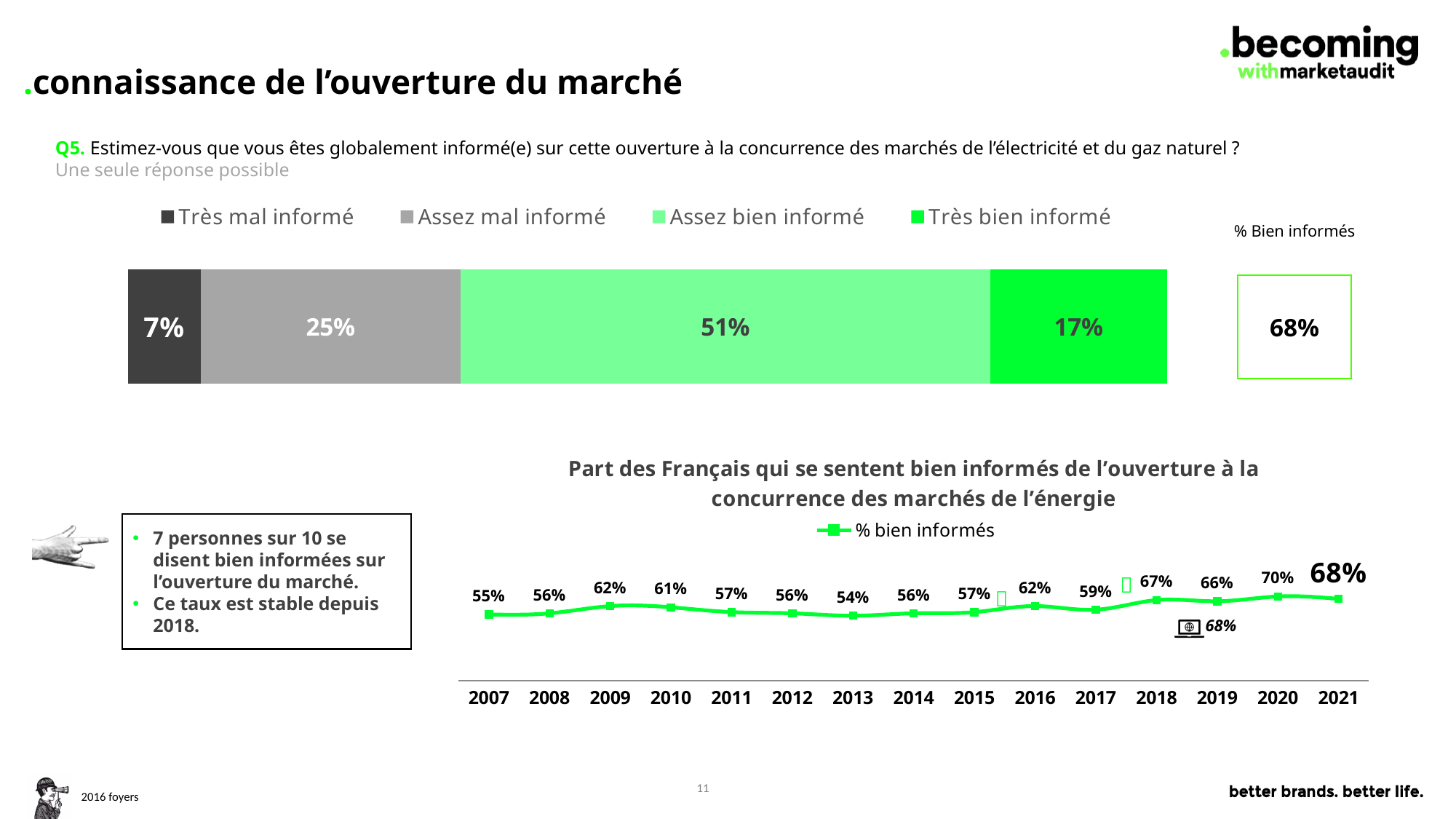
What kind of chart is the bottom chart on the slide? Line chart In the chart titled "Part des Français qui se sentent bien informés...", what is the value for 2013? 54% In the top stacked bar chart, how many series does the legend list? 4 In the top stacked bar chart, what percentage of respondents answered "Assez bien informé"? 51% In the top stacked bar chart, what is the difference between the "Assez mal informé" and "Très bien informé" shares? 8% In the top stacked bar chart, what percentage of respondents answered "Très mal informé"? 7% In the chart titled "Part des Français qui se sentent bien informés...", which year has the highest value? 2020 In the chart titled "Part des Français qui se sentent bien informés...", what is the value for 2018? 67% In the top stacked bar chart, which response category has the largest share? Assez bien informé In the chart titled "Part des Français qui se sentent bien informés...", which year has the lowest value? 2013 In the chart titled "Part des Français qui se sentent bien informés...", what is the difference between the 2021 value and the 2007 value? 13% In the chart titled "Part des Français qui se sentent bien informés...", how many years are plotted on the x axis? 15